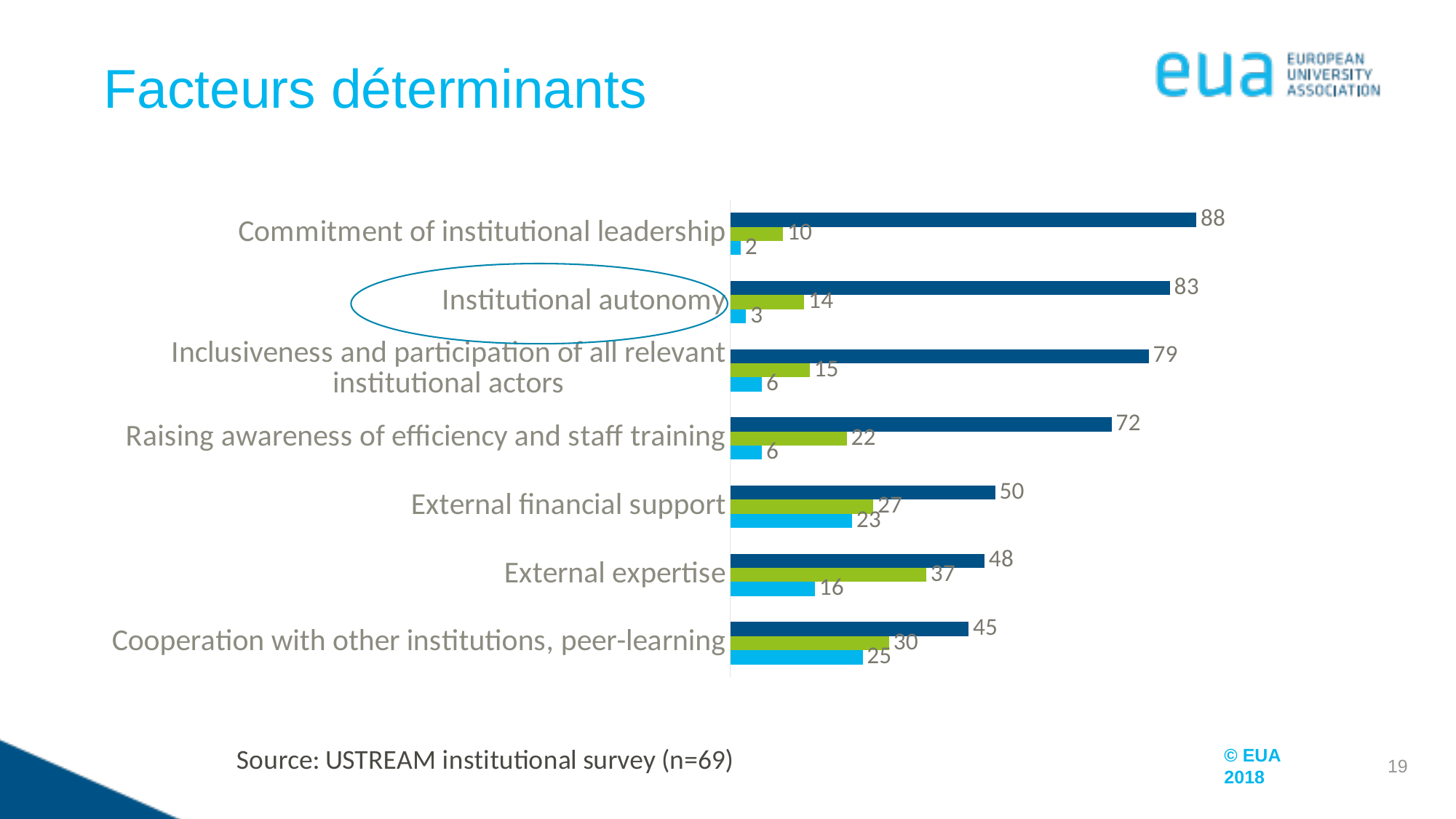
What is the value of the green bar for Institutional autonomy? 14 How many categories are shown on the chart? 7 Which category has the highest dark blue bar value? Commitment of institutional leadership Which category has the lowest light blue bar value? Commitment of institutional leadership What kind of chart is shown on the slide? Bar chart How many bars are shown for each category? 3 What is the value of the dark blue bar for Commitment of institutional leadership? 88 What is the difference between the dark blue bar values for Institutional autonomy and Cooperation with other institutions, peer-learning? 38 What is the value of the light blue bar for External financial support? 23 Which category label is circled on the chart? Institutional autonomy Which is larger: the green bar for Raising awareness of efficiency and staff training or the green bar for Cooperation with other institutions, peer-learning? Cooperation with other institutions, peer-learning What is the value of the green bar for External expertise? 37